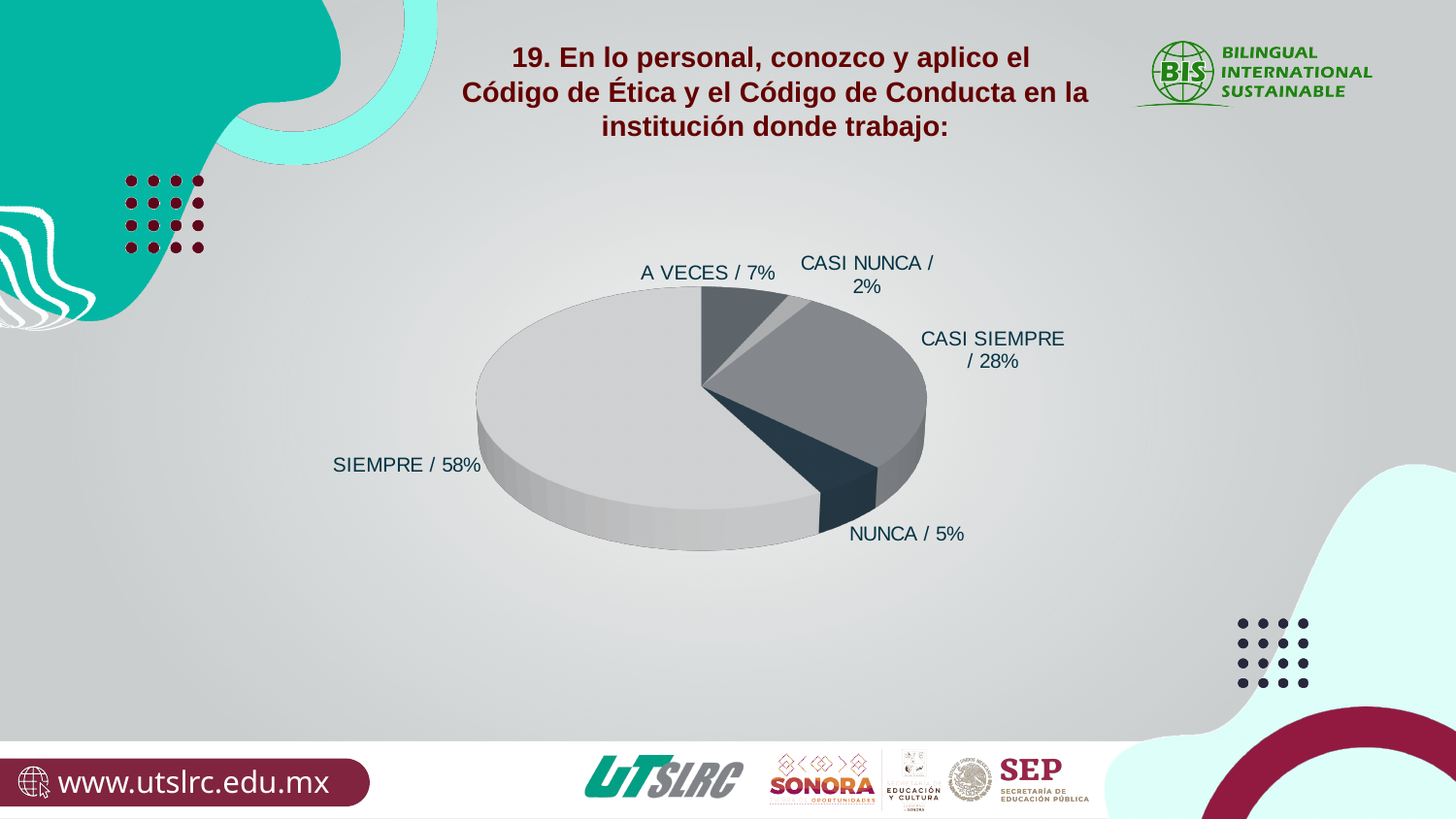
What kind of chart is shown on the slide? pie chart Which category has the largest share of the pie? SIEMPRE What percentage of responses are CASI NUNCA? 2% Which category has the smallest share of the pie? CASI NUNCA What is the number of the survey question shown in the chart title? 19 What percentage of responses are SIEMPRE? 58% What is the difference in percentage points between SIEMPRE and CASI SIEMPRE? 30 What percentage of responses are CASI SIEMPRE? 28% What percentage of responses are NUNCA? 5% Which is larger, the share for NUNCA or the share for A VECES? A VECES How many categories are shown in the pie chart? 5 What percentage of responses are A VECES? 7%